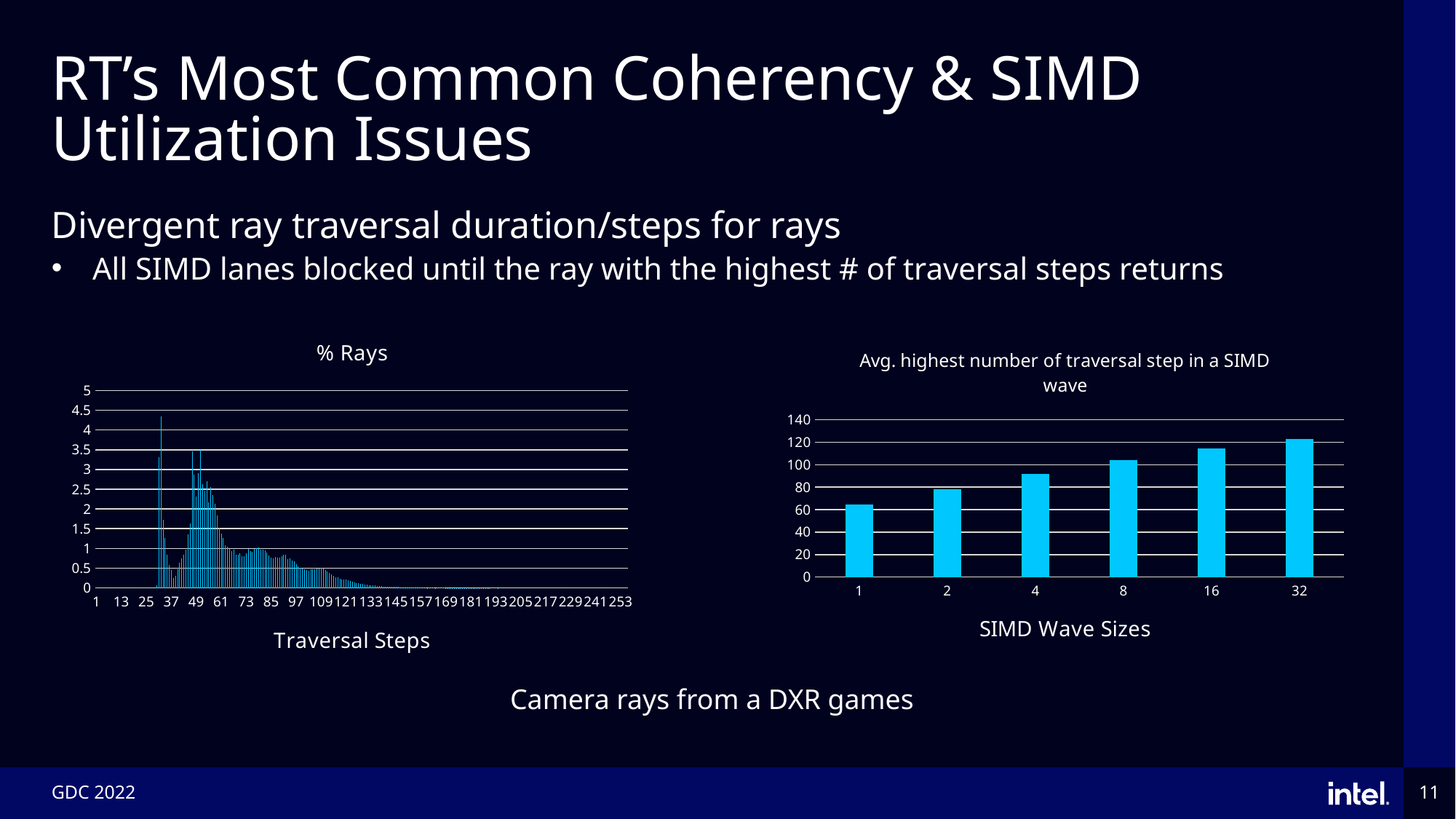
In the right-hand chart, is the value for SIMD wave size 1 greater or less than 80? less In the right-hand chart, is the value for SIMD wave size 2 greater or less than 100? less In the right-hand chart, which is larger: the value for SIMD wave size 8 or for SIMD wave size 2? 8 What is the x-axis label of the left-hand chart titled '% Rays'? Traversal Steps In the right-hand chart, which SIMD wave size has the lowest average number of traversal steps? 1 In the right-hand chart, is the value for SIMD wave size 16 greater or less than 100? greater In the right-hand chart, how many SIMD wave sizes are plotted? 6 What kind of chart is the right-hand chart titled 'Avg. highest number of traversal step in a SIMD wave'? bar chart In the right-hand chart, which SIMD wave size has the highest average number of traversal steps? 32 In the right-hand chart, do the values rise or fall as the SIMD wave size increases along the x axis? rise What is the x-axis label of the right-hand chart? SIMD Wave Sizes